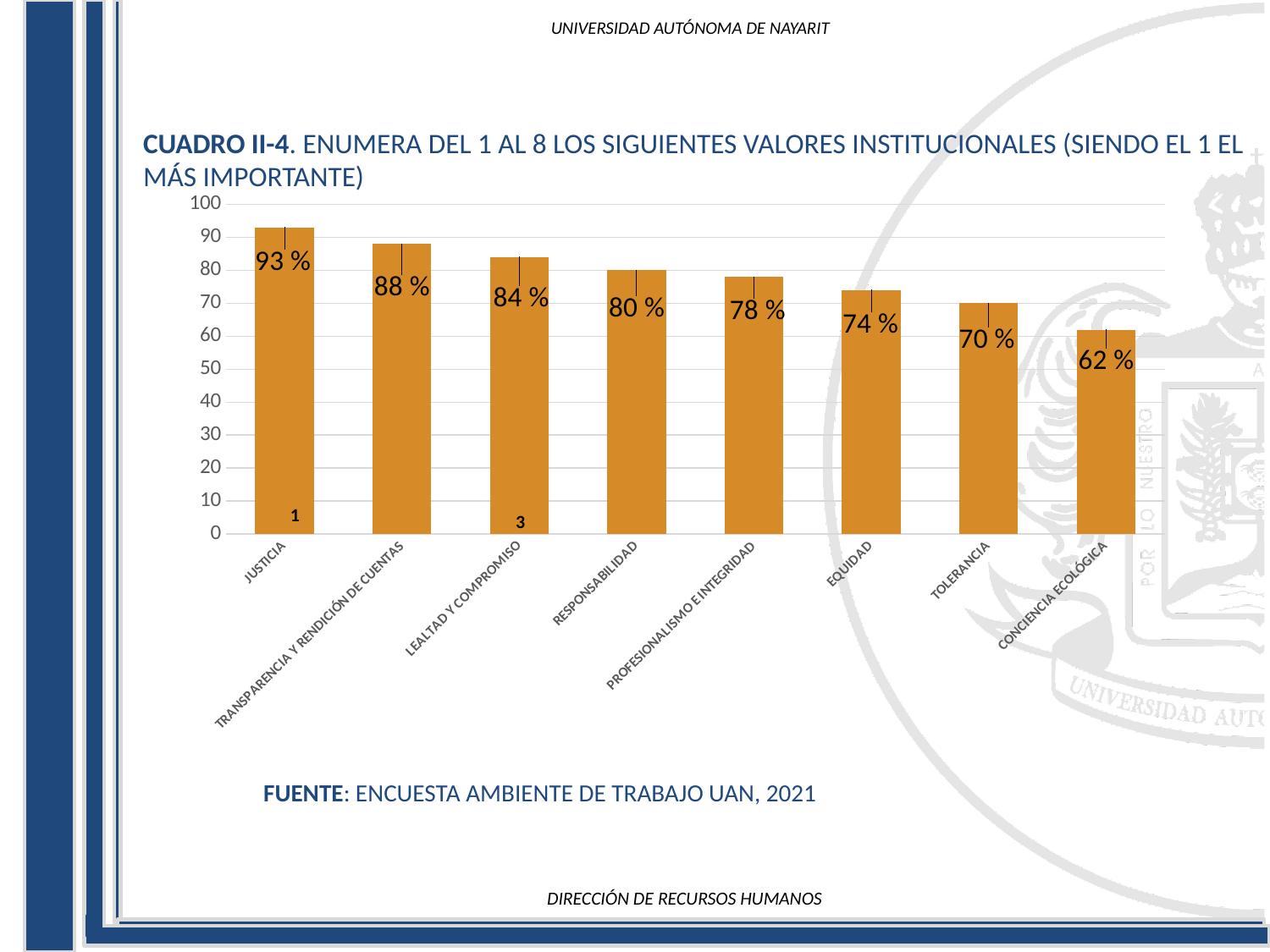
Which category has the highest value? JUSTICIA What is the value for EQUIDAD? 74 % What is the value for JUSTICIA? 93 % What is the value for TOLERANCIA? 70 % What source is cited below the chart? ENCUESTA AMBIENTE DE TRABAJO UAN, 2021 How many categories are shown on the chart? 8 Which category has the lowest value? CONCIENCIA ECOLÓGICA Which is larger, the value for RESPONSABILIDAD or the value for PROFESIONALISMO E INTEGRIDAD? RESPONSABILIDAD Is the value for LEALTAD Y COMPROMISO greater or less than 80? greater Do the values rise or fall from left to right along the x axis? fall What kind of chart is shown on the slide? bar chart What is the difference between the values for JUSTICIA and CONCIENCIA ECOLÓGICA? 31 %